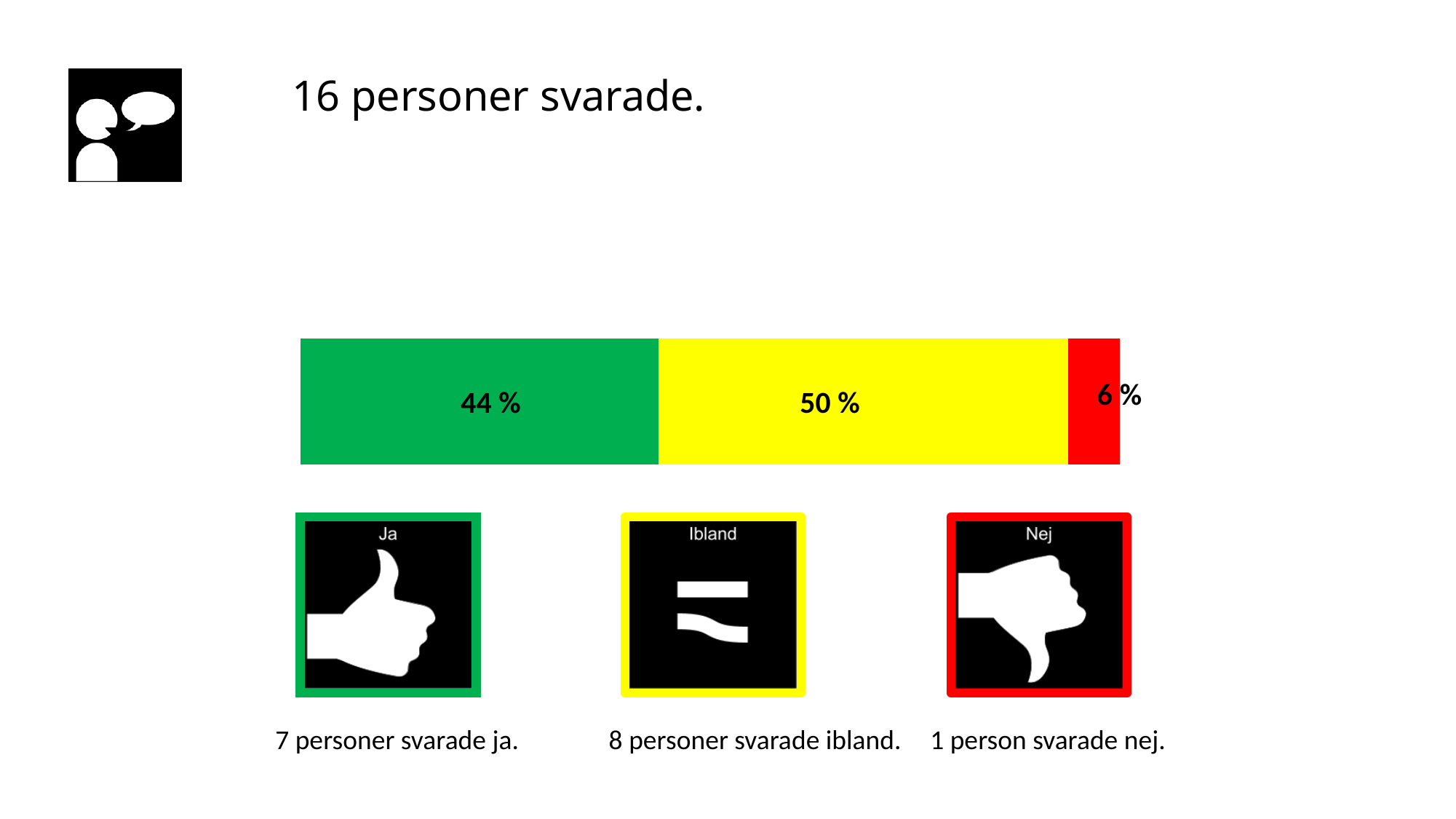
Which segment is larger, "Ja" or "Nej"? Ja How many segments does the bar have? 3 Which answer has the smallest share of the bar? Nej What percentage of respondents answered "Nej" (red segment)? 6 % Which answer has the largest share of the bar? Ibland What percentage of respondents answered "Ja" (green segment)? 44 % What kind of chart is shown on the slide? Stacked bar chart What percentage of respondents answered "Ibland" (yellow segment)? 50 % How many people answered in total, according to the slide title? 16 What is the total of the three percentages shown on the bar? 100 % What is the difference in percentage points between the "Ibland" and "Ja" segments? 6 What colour is the segment for "Nej"? Red